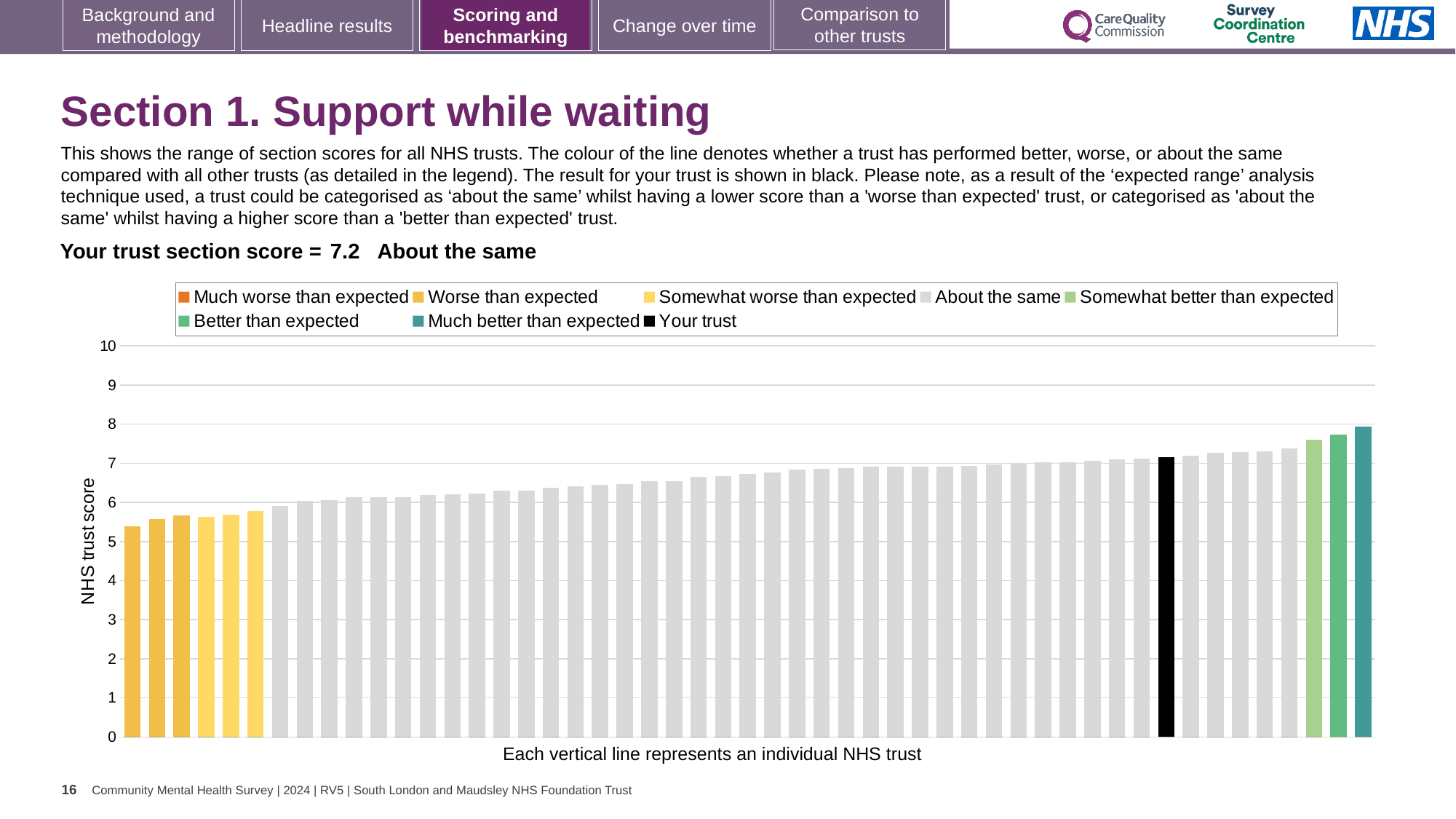
How many entries does the chart legend list? 8 What colour is used for the bar representing your trust? black What is the label on the vertical axis of the chart? NHS trust score How many bars are shown in the teal 'Much better than expected' colour? 1 Is the value of the shortest bar in the chart greater or less than 5? greater What kind of chart is shown on the slide? bar chart What is the section score for your trust shown on the slide? 7.2 How is your trust's section score categorised compared with other trusts? About the same Do the bar heights rise or fall from left to right across the chart? rise How many bars are coloured yellow at the left of the chart? 6 Is the value for your trust (the black bar) greater or less than 7? greater